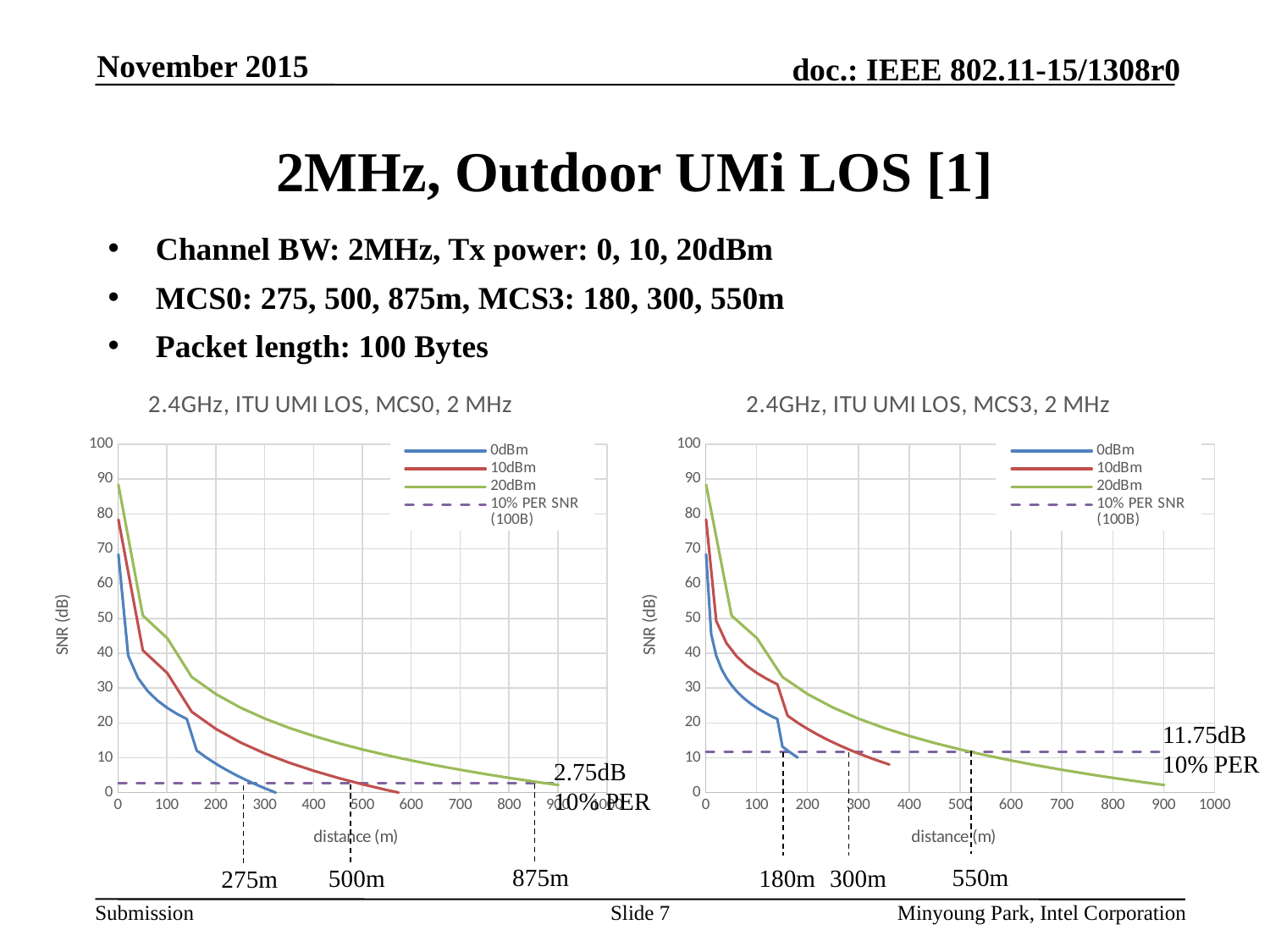
In the right chart (MCS3), at what distance does the 10dBm curve cross the 10% PER SNR line? 300m In the right chart (MCS3), what is the 10% PER SNR level marked by the dashed line? 11.75dB In the left chart (MCS0), what is the 10% PER SNR level marked by the dashed line? 2.75dB In the right chart (MCS3), is the SNR of the 0dBm series at 100 m greater or less than 30? less What is the title of the right chart? 2.4GHz, ITU UMI LOS, MCS3, 2 MHz What kind of chart is the left chart titled "2.4GHz, ITU UMI LOS, MCS0, 2 MHz"? line chart How many series does the legend of the right chart (MCS3) list? 4 In the left chart (MCS0), at what distance does the 20dBm curve cross the 10% PER SNR line? 875m In the left chart (MCS0), which series has the highest SNR at a distance of 200 m? 20dBm In the right chart (MCS3), which series has the lowest SNR at a distance of 100 m? 0dBm In the left chart (MCS0), is the SNR of the 20dBm series at distance 0 greater or less than 80? greater In the left chart (MCS0), does SNR rise or fall as distance increases? fall